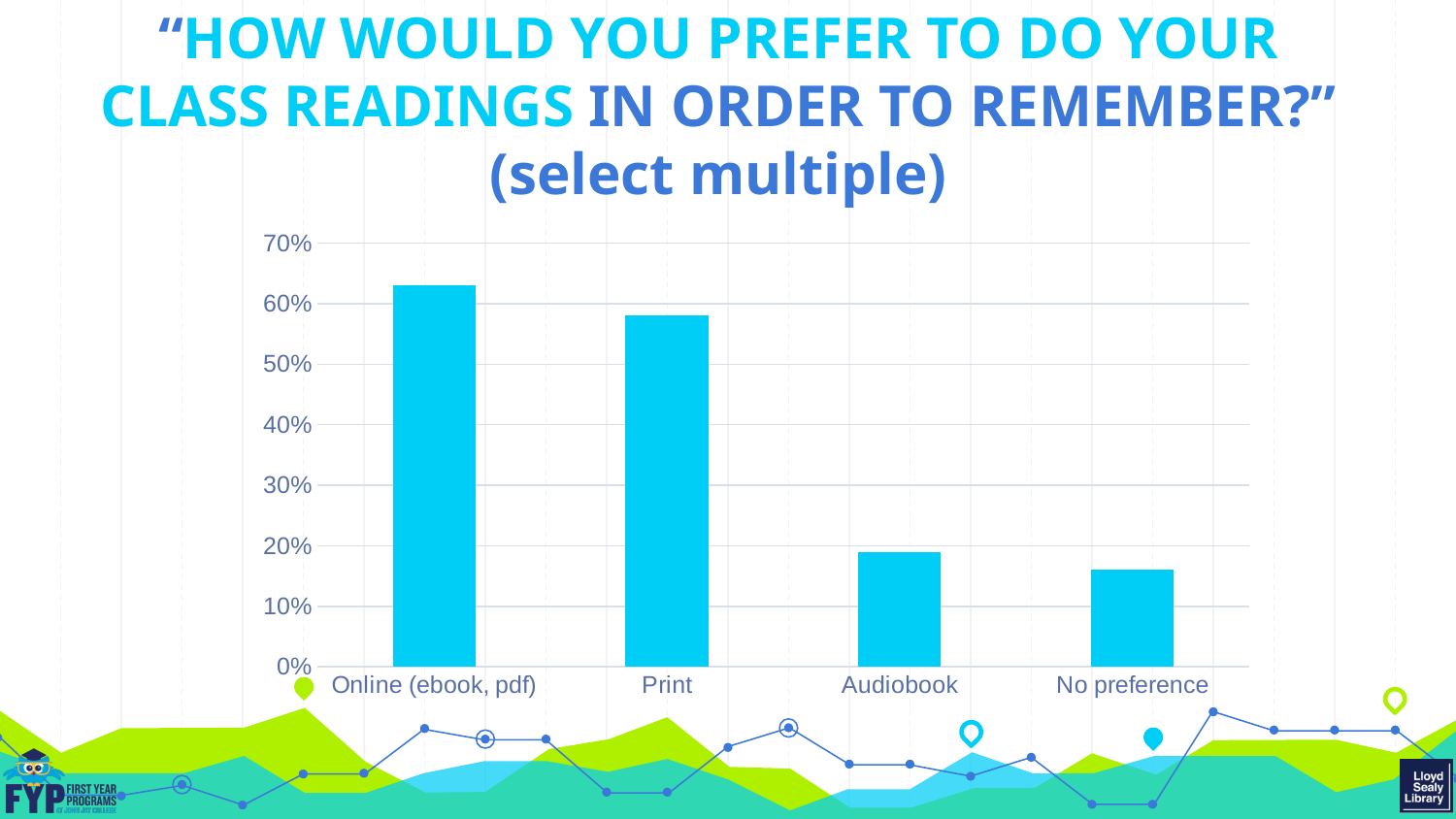
Is the value for Online (ebook, pdf) greater or less than 60%? greater Do the bar values rise or fall from left to right along the x axis? fall Which category has the highest value in the chart? Online (ebook, pdf) How many categories are shown on the x axis of the chart? 4 What is the highest value shown on the y axis of the chart? 70% What kind of chart is shown on the slide? bar chart Is the value for Print greater or less than 60%? less Which is larger, the value for Online (ebook, pdf) or the value for Print? Online (ebook, pdf) Which is larger, the value for Print or the value for Audiobook? Print Which category has the lowest value in the chart? No preference Is the value for No preference greater or less than 10%? greater